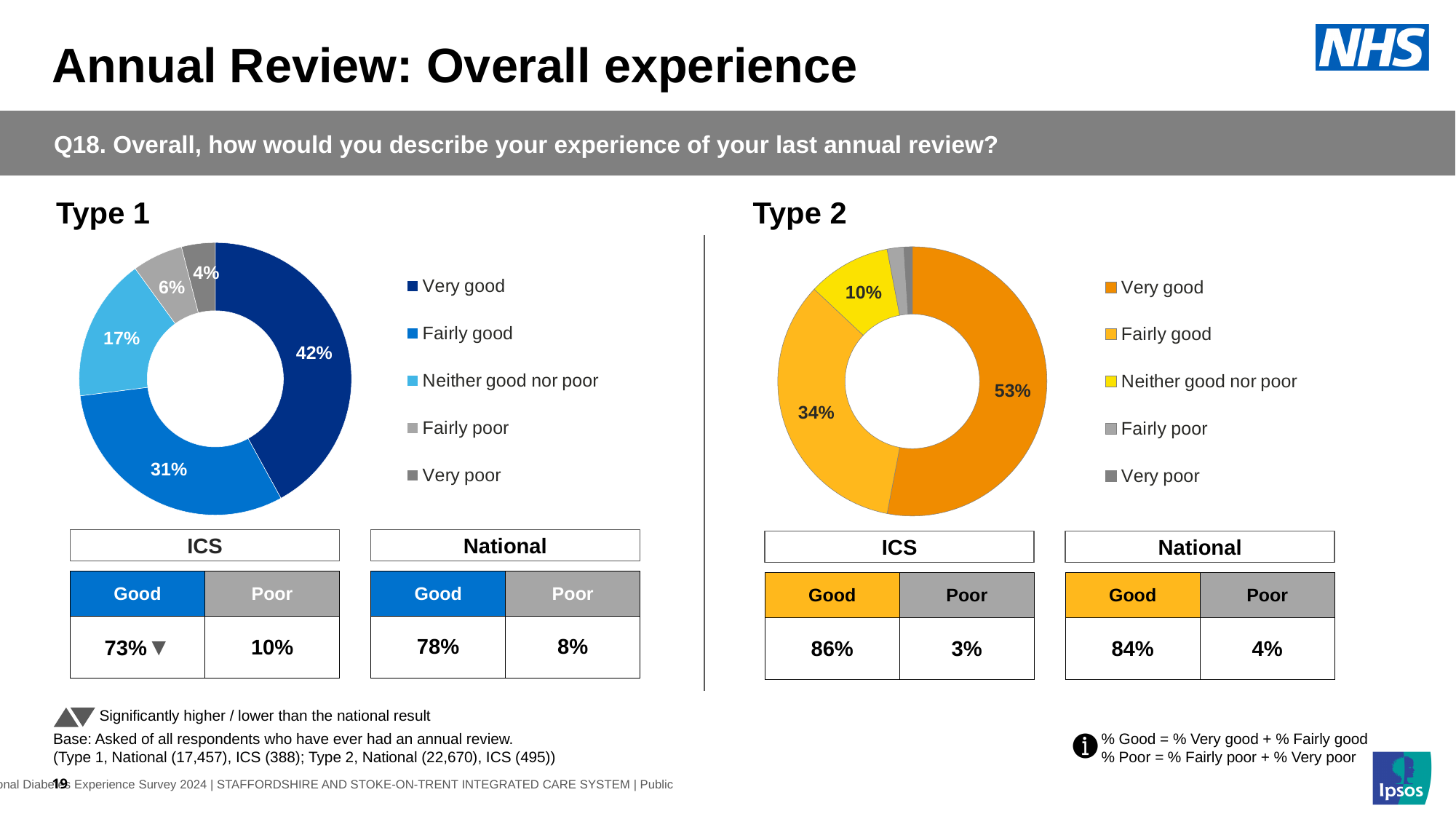
In the Type 2 chart, which response category has the largest share? Very good In the Type 2 chart, what percentage of respondents said 'Fairly good'? 34% In the Type 2 chart, what percentage of respondents said 'Neither good nor poor'? 10% In the Type 1 chart, what percentage of respondents said 'Very good'? 42% In the Type 1 chart, which response category has the largest share? Very good In the Type 1 chart, what is the difference between the 'Very good' and 'Fairly good' percentages? 11% In the Type 1 chart, what percentage of respondents said 'Neither good nor poor'? 17% What kind of chart is used to show the Type 2 results? Pie chart (donut) In the Type 2 chart, what is the difference between the 'Very good' and 'Fairly good' percentages? 19% Which chart has the larger 'Very good' share, Type 1 or Type 2? Type 2 In the Type 1 chart, which response category has the smallest share? Very poor How many response categories does the legend of the Type 1 chart list? 5